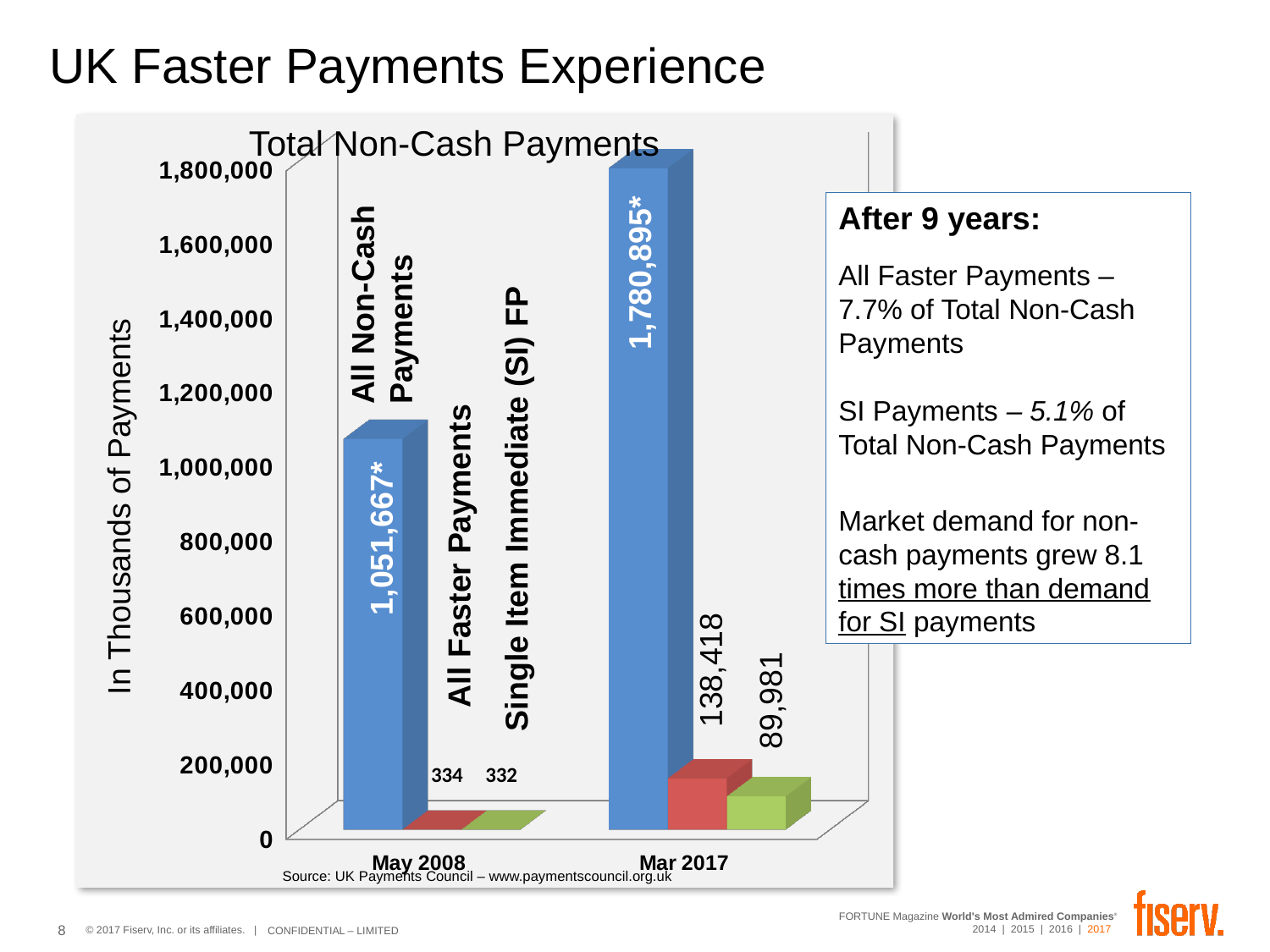
Which is larger for Mar 2017: All Faster Payments or Single Item Immediate (SI) FP? All Faster Payments What is the value of All Faster Payments for May 2008? 334 What is the value of Single Item Immediate (SI) FP for May 2008? 332 What is the value of All Non-Cash Payments for Mar 2017? 1,780,895* What is the value of All Non-Cash Payments for May 2008? 1,051,667* How many time periods (categories) are shown on the x axis? 2 What is the title of the chart? Total Non-Cash Payments What is the difference between All Faster Payments and Single Item Immediate (SI) FP in Mar 2017? 48,437 What is the value of All Faster Payments for Mar 2017? 138,418 Does All Non-Cash Payments rise or fall from May 2008 to Mar 2017? rise What kind of chart is shown on the slide? bar chart How many series are plotted in the chart? 3